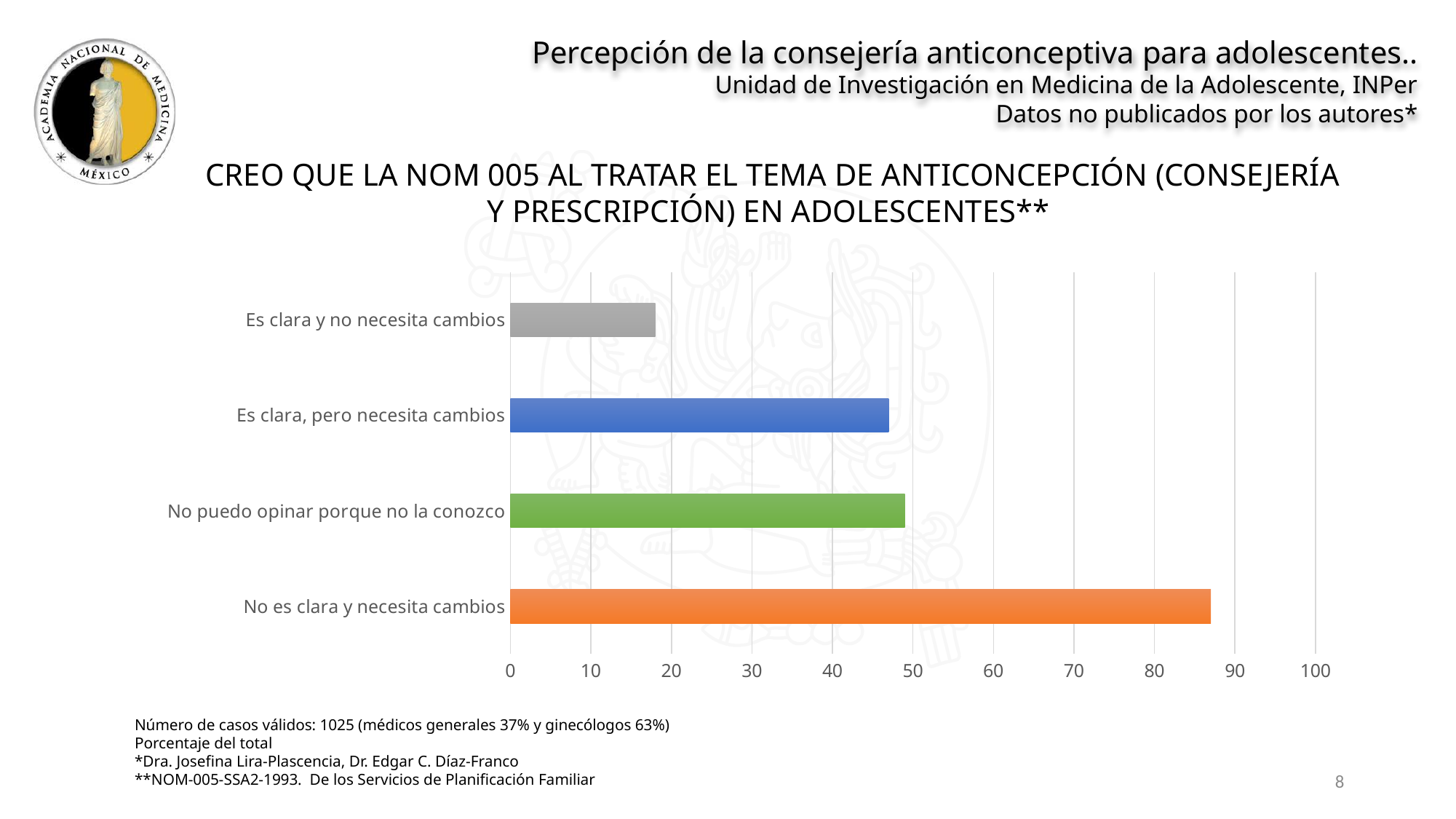
Is the value for "No es clara y necesita cambios" greater or less than 90? less Which category has the lowest value? Es clara y no necesita cambios Is the value for "Es clara y no necesita cambios" greater or less than 20? less Is the value for "Es clara y no necesita cambios" greater or less than 10? greater What colour is the bar for "No es clara y necesita cambios"? orange Which category has the highest value? No es clara y necesita cambios Which is larger, the value for "No es clara y necesita cambios" or the value for "Es clara, pero necesita cambios"? No es clara y necesita cambios How many categories does the chart show? 4 What kind of chart is shown on the slide? bar chart